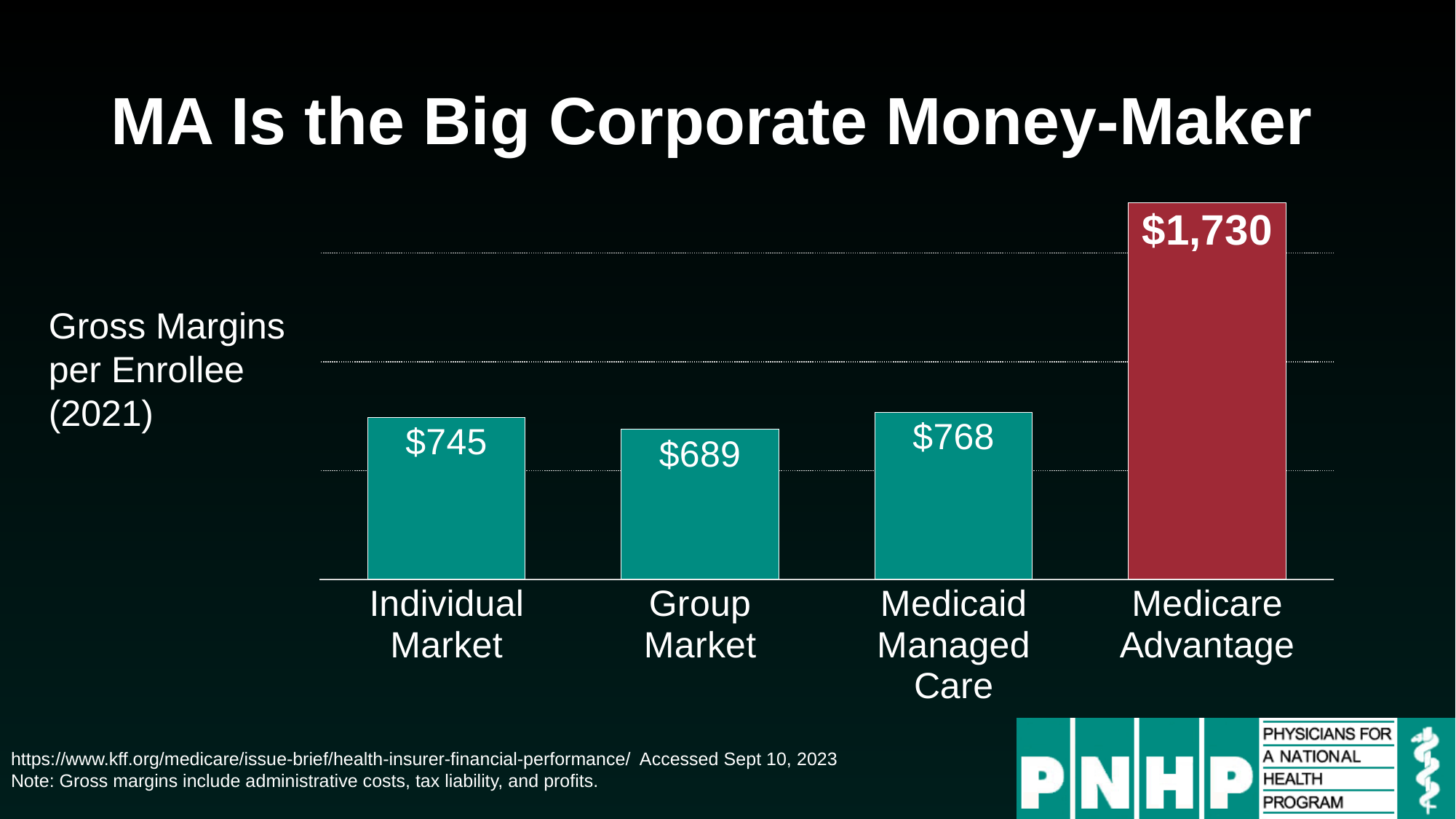
What is the gross margin per enrollee for Medicare Advantage? $1,730 How many categories are shown in the chart? 4 What kind of chart is shown on the slide? Bar chart Which category has the highest gross margin per enrollee? Medicare Advantage Which bar is shown in a different colour (red) from the others? Medicare Advantage What is the gross margin per enrollee for the Individual Market? $745 What is the difference between the gross margin per enrollee for the Individual Market and the Group Market? $56 What is the difference between the gross margin per enrollee for Medicare Advantage and for Medicaid Managed Care? $962 What is the gross margin per enrollee for the Group Market? $689 What is the gross margin per enrollee for Medicaid Managed Care? $768 Which has a larger gross margin per enrollee, Medicaid Managed Care or the Individual Market? Medicaid Managed Care Which category has the lowest gross margin per enrollee? Group Market